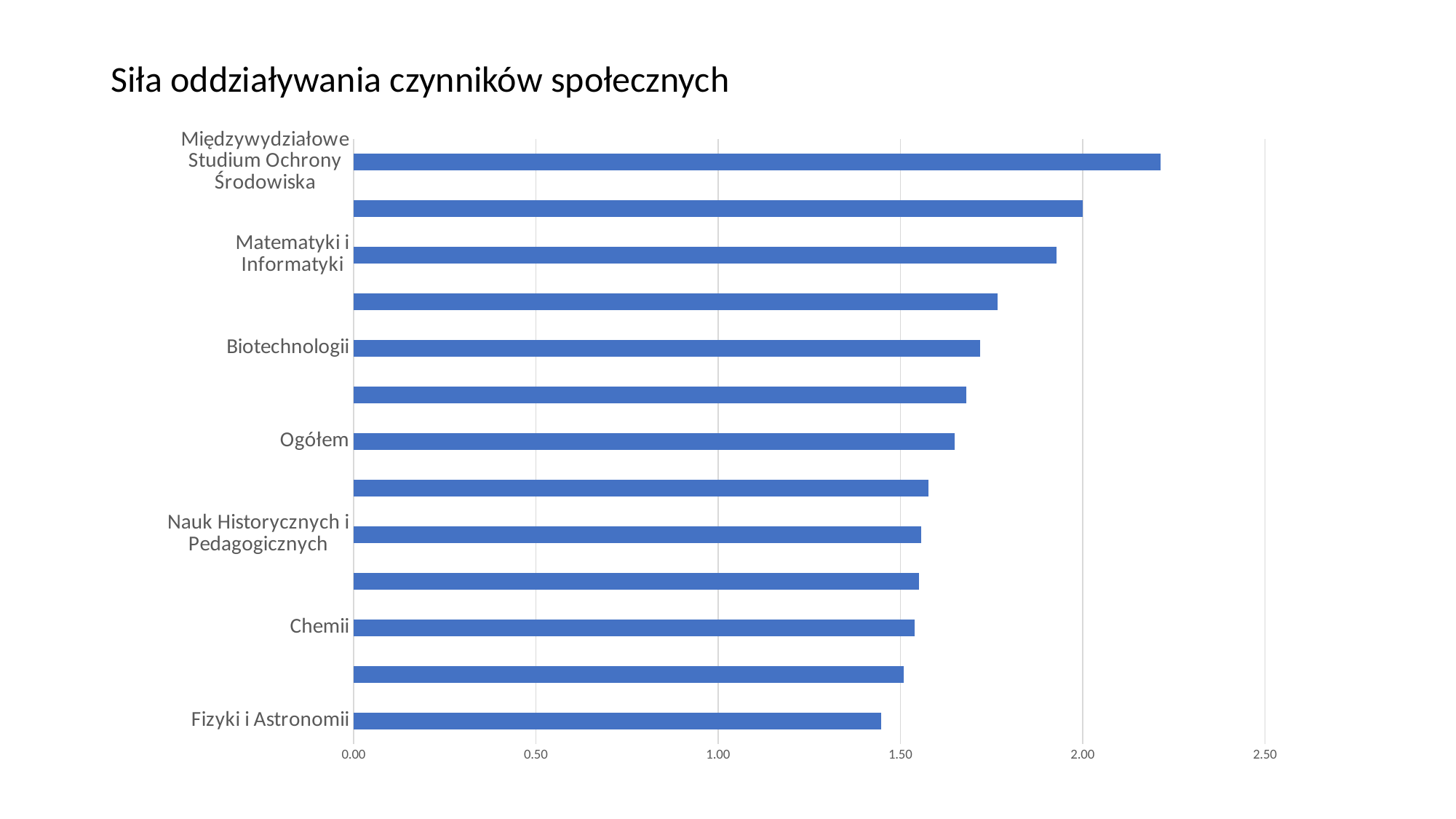
Is the value for Fizyki i Astronomii greater or less than 1.50? less Is the value for Chemii greater or less than 1.00? greater Is the value for Ogółem greater or less than 2.00? less What kind of chart is shown on the slide? bar chart What is the title of the chart? Siła oddziaływania czynników społecznych Which labeled category has the shortest bar? Fizyki i Astronomii How many bars are plotted in the chart? 13 Which has the larger value, Ogółem or Fizyki i Astronomii? Ogółem Which labeled category has the longest bar? Międzywydziałowe Studium Ochrony Środowiska Which has the larger value, Matematyki i Informatyki or Biotechnologii? Matematyki i Informatyki